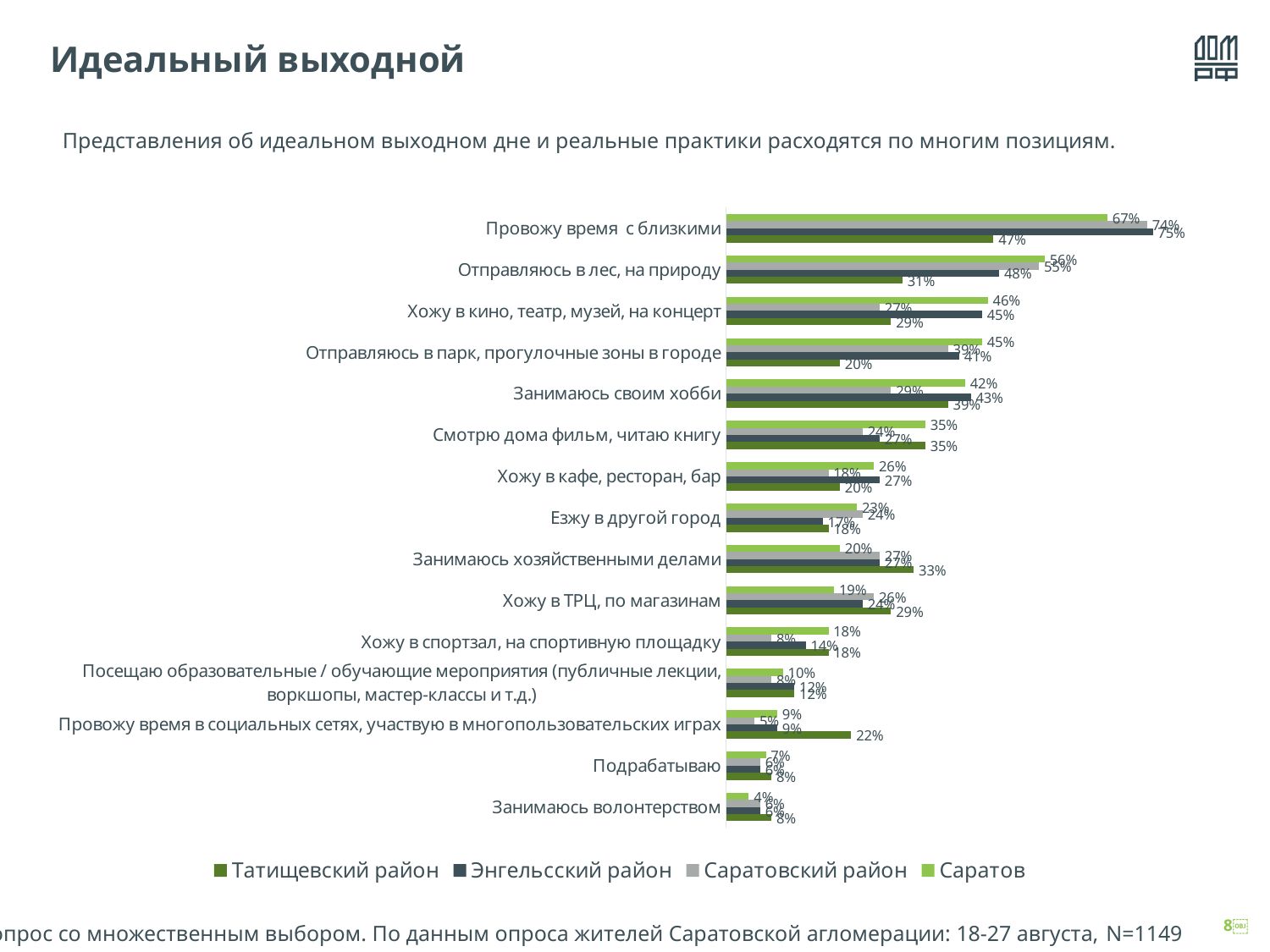
What is the value for Саратов in the category «Провожу время с близкими»? 67% How many series does the legend list? 4 In the category «Провожу время с близкими», what is the difference between the values for Энгельсский район (75%) and Татищевский район (47%)? 28 percentage points How many categories (activities) are plotted on the chart? 15 What is the value for Татищевский район in the category «Провожу время с близкими»? 47% Which category has the highest value for the Саратов series? Провожу время с близкими In the category «Хожу в кино, театр, музей, на концерт», which is larger: the value for Саратов or for Татищевский район? Саратов Which category has the lowest value for the Саратов series? Занимаюсь волонтерством What is the value for Татищевский район in the category «Провожу время в социальных сетях, участвую в многопользовательских играх»? 22% What is the value for Энгельсский район in the category «Отправляюсь в лес, на природу»? 48% What kind of chart is shown on the slide? Bar chart What is the title of the chart slide? Идеальный выходной